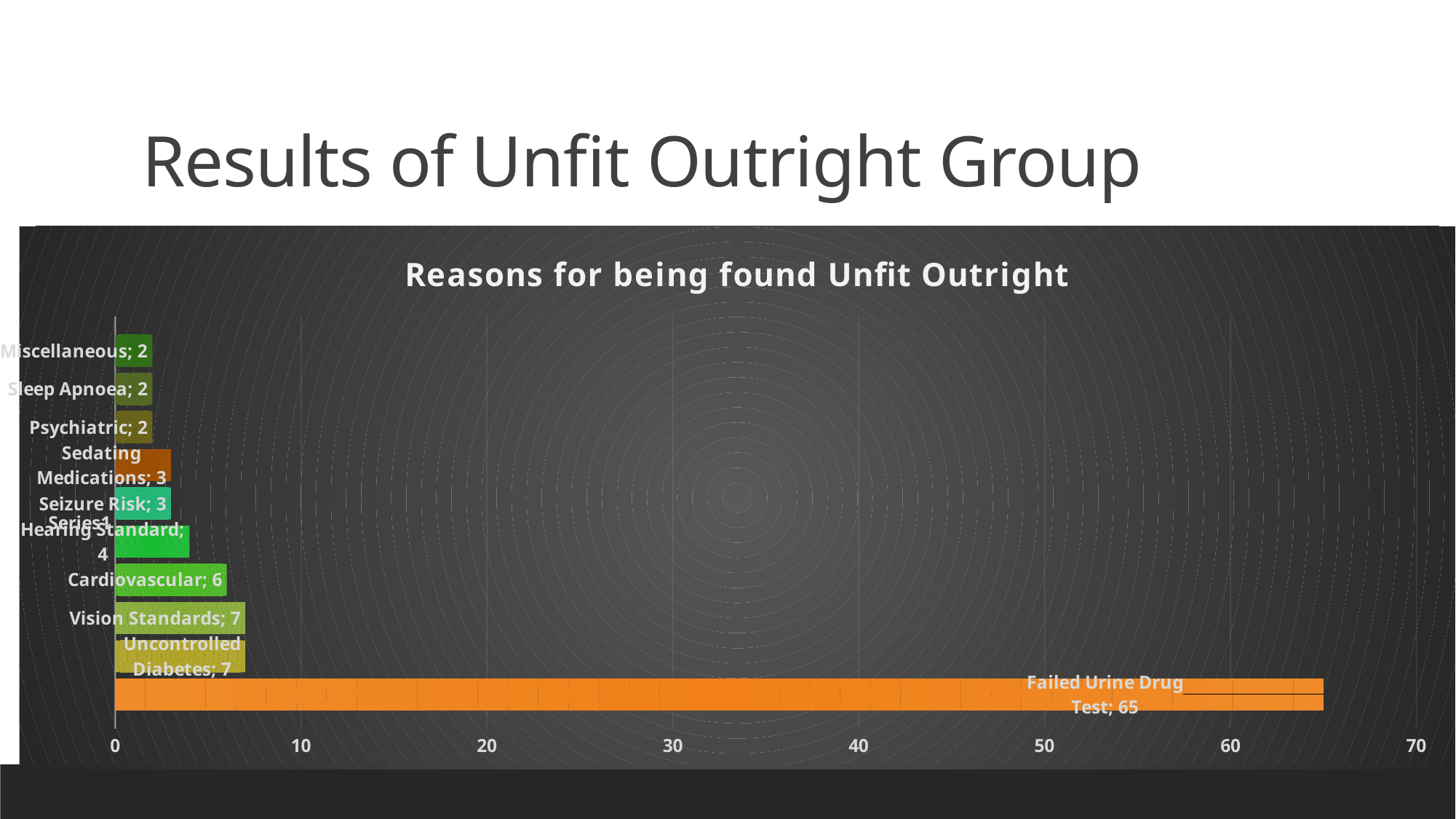
Which is larger, the value for Vision Standards or the value for Cardiovascular? Vision Standards What is the title of the chart? Reasons for being found Unfit Outright What is the value for Sedating Medications? 3 What kind of chart is shown on the slide? bar chart What is the value for Failed Urine Drug Test? 65 How many categories are shown in the chart? 10 What is the difference between the values for Cardiovascular and Hearing Standard? 2 What is the difference between the values for Failed Urine Drug Test and Vision Standards? 58 Which category has the highest value? Failed Urine Drug Test What is the value for Cardiovascular? 6 What is the value for Hearing Standard? 4 Is the value for Failed Urine Drug Test greater or less than 60? greater